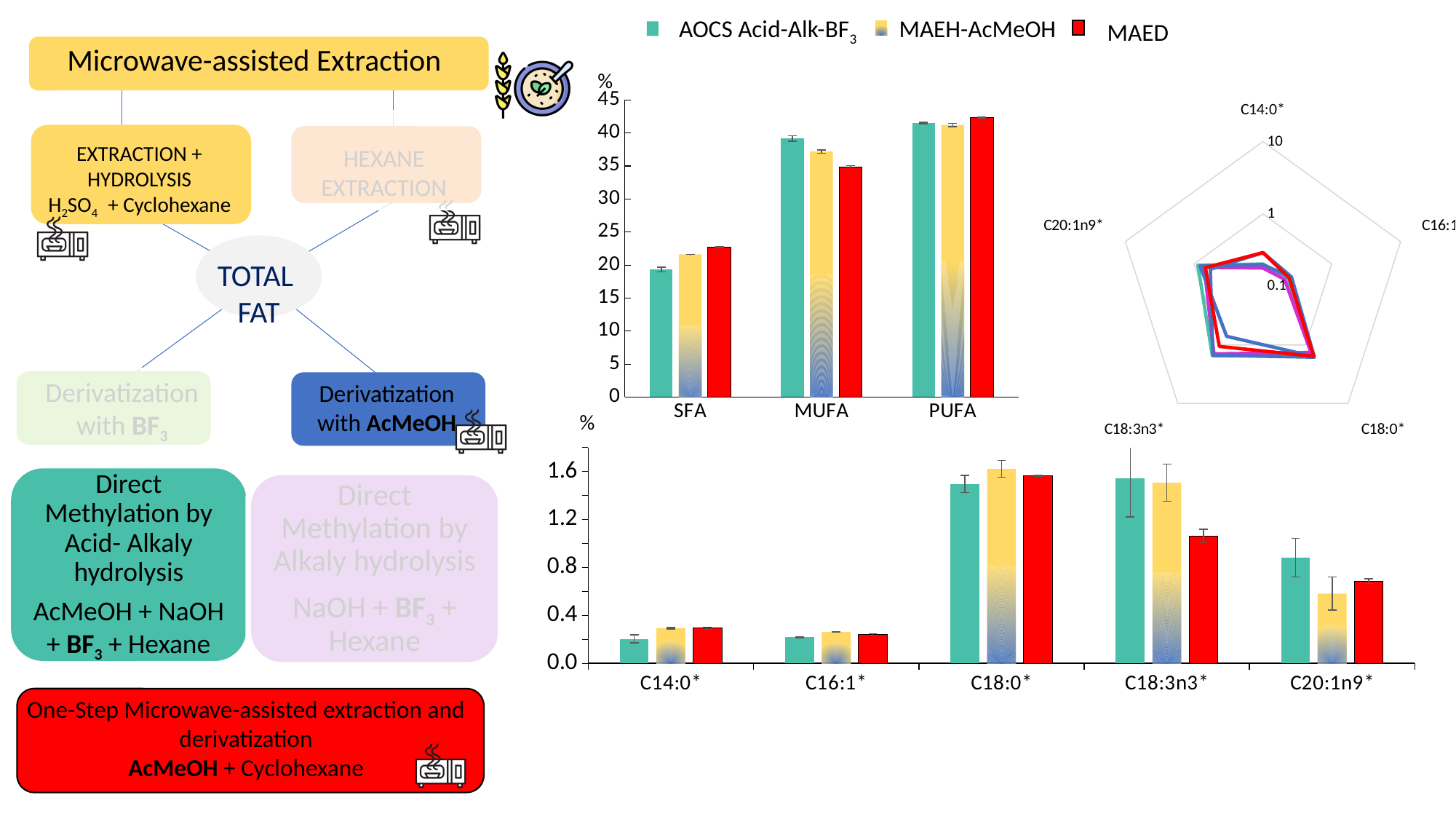
In the top bar chart (SFA, MUFA, PUFA), which category has the lowest values across all three series? SFA What kind of chart is the pentagon-shaped chart on the right side of the slide? radar chart What kind of chart is the top-right chart with categories SFA, MUFA and PUFA? bar chart In the bottom bar chart (C14:0* to C20:1n9*), is the C18:3n3* value for MAED greater or less than 1.2? less In the bottom bar chart (C14:0* to C20:1n9*), is the C20:1n9* value for AOCS Acid-Alk-BF3 greater or less than 0.8? greater In the top bar chart (SFA, MUFA, PUFA), is the SFA value for MAED greater or less than 20? greater In the top bar chart (SFA, MUFA, PUFA), for MUFA, which is larger: AOCS Acid-Alk-BF3 or MAED? AOCS Acid-Alk-BF3 In the bottom bar chart (C14:0* to C20:1n9*), for C18:3n3*, which is larger: AOCS Acid-Alk-BF3 or MAED? AOCS Acid-Alk-BF3 In the top bar chart (SFA, MUFA, PUFA), how many categories are shown on the x axis? 3 In the bottom bar chart (C14:0* to C20:1n9*), how many categories are shown on the x axis? 5 How many series does the legend at the top of the slide list? 3